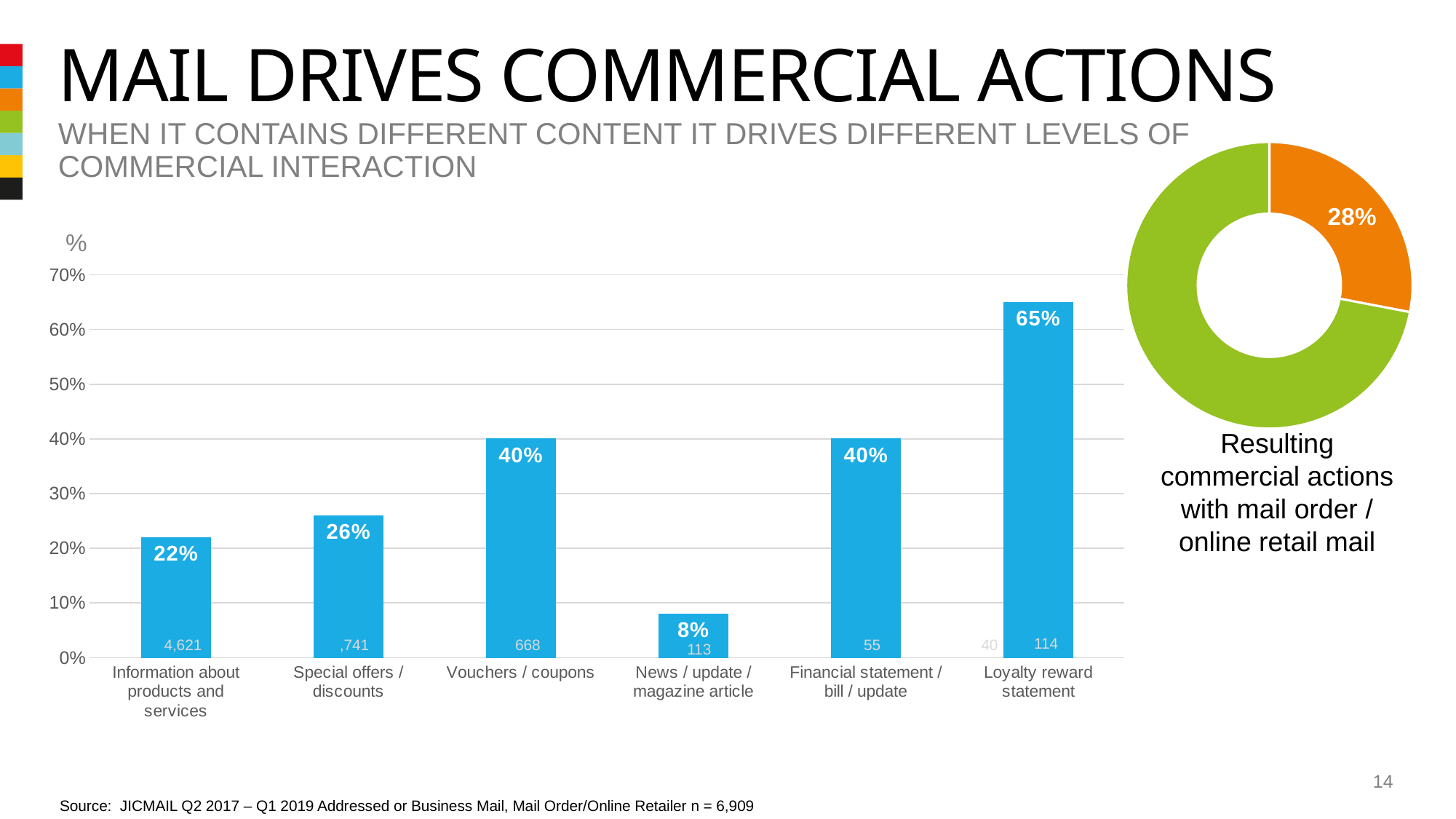
In the bar chart, is the value for Financial statement / bill / update greater or less than 30%? greater In the donut chart on the right, what share does the orange slice represent? 28% In the bar chart, which category has the highest value? Loyalty reward statement How many categories are shown in the bar chart? 6 In the bar chart, which category has the lowest value? News / update / magazine article In the bar chart, what is the value for Special offers / discounts? 26% In the bar chart, which is larger: the value for Special offers / discounts or the value for Information about products and services? Special offers / discounts In the bar chart, what is the difference between the values for Loyalty reward statement and Vouchers / coupons? 25% In the bar chart, what is the value for News / update / magazine article? 8% What kind of chart is the chart on the left of the slide? bar chart In the bar chart, what is the value for Loyalty reward statement? 65% What kind of chart is the chart on the right of the slide? donut chart